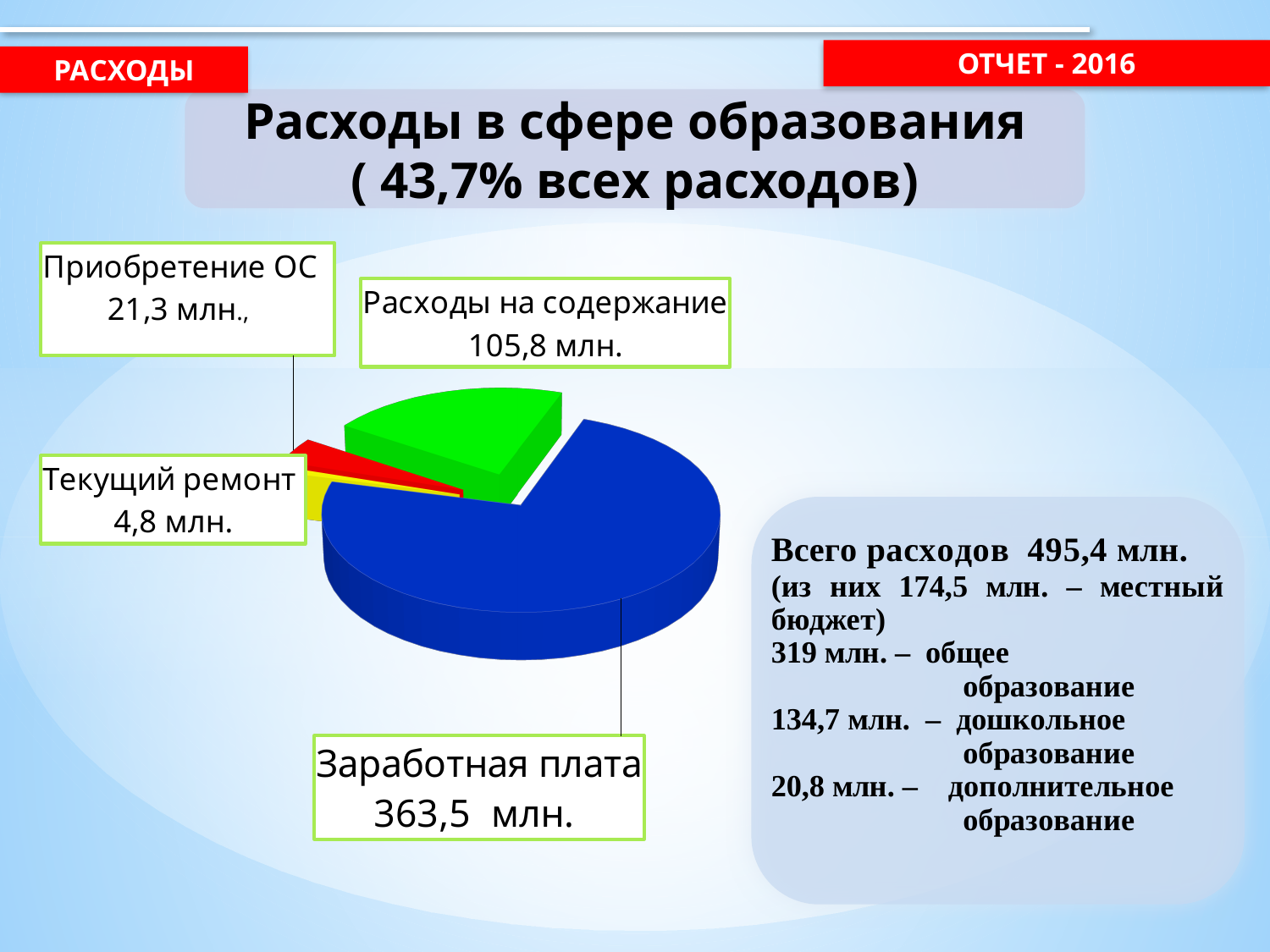
Which is larger, Расходы на содержание or Приобретение ОС? Расходы на содержание Which category has the smallest slice of the pie chart? Текущий ремонт Which category has the largest slice of the pie chart? Заработная плата What is the value for Заработная плата on the pie chart? 363,5 млн. What is the difference between Заработная плата and Расходы на содержание? 257,7 млн. What is the difference between Приобретение ОС and Текущий ремонт? 16,5 млн. What is the value for Расходы на содержание on the pie chart? 105,8 млн. Which category is shown by the blue slice of the pie chart? Заработная плата What kind of chart is shown on the slide? Pie chart What is the value for Приобретение ОС on the pie chart? 21,3 млн. How many categories are shown on the pie chart? 4 What is the value for Текущий ремонт on the pie chart? 4,8 млн.